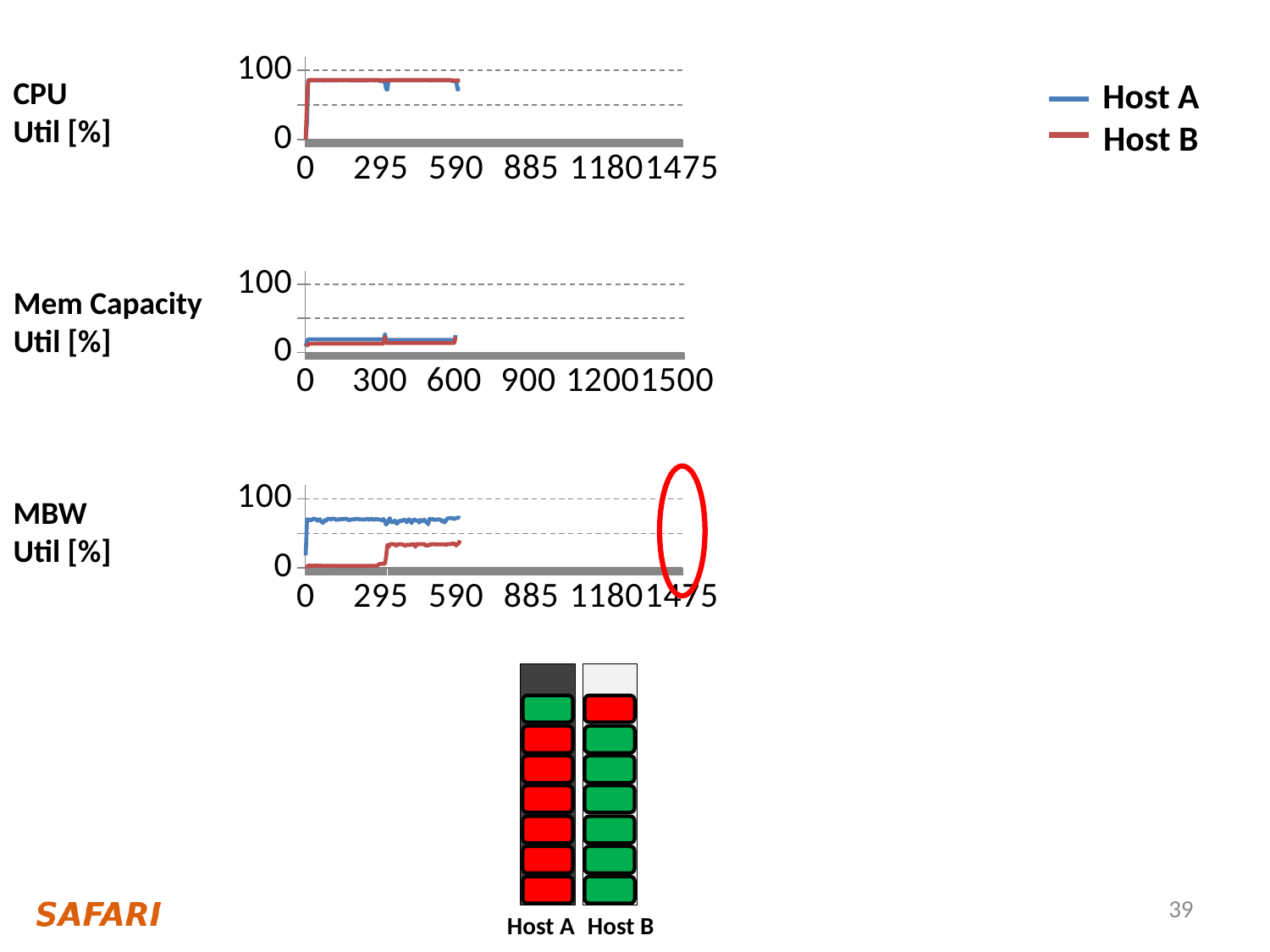
In the MBW Util [%] chart, which host has the higher utilization, Host A or Host B? Host A In the CPU Util [%] chart, is the value for Host B after the initial rise greater or less than 50? greater What is the highest y-axis tick label shown on the Mem Capacity Util [%] chart? 100 In the MBW Util [%] chart, is the value for Host B at x = 0 greater or less than 50? less In the MBW Util [%] chart, is the value for Host A greater or less than 50? greater What kind of chart is the CPU Util [%] chart? line chart Which series is drawn in blue in the legend? Host A In the MBW Util [%] chart, does the Host B line rise or fall after x = 295? rise What is the last x-axis tick label on the Mem Capacity Util [%] chart? 1500 Which series is drawn in red in the legend? Host B How many series does the legend list? 2